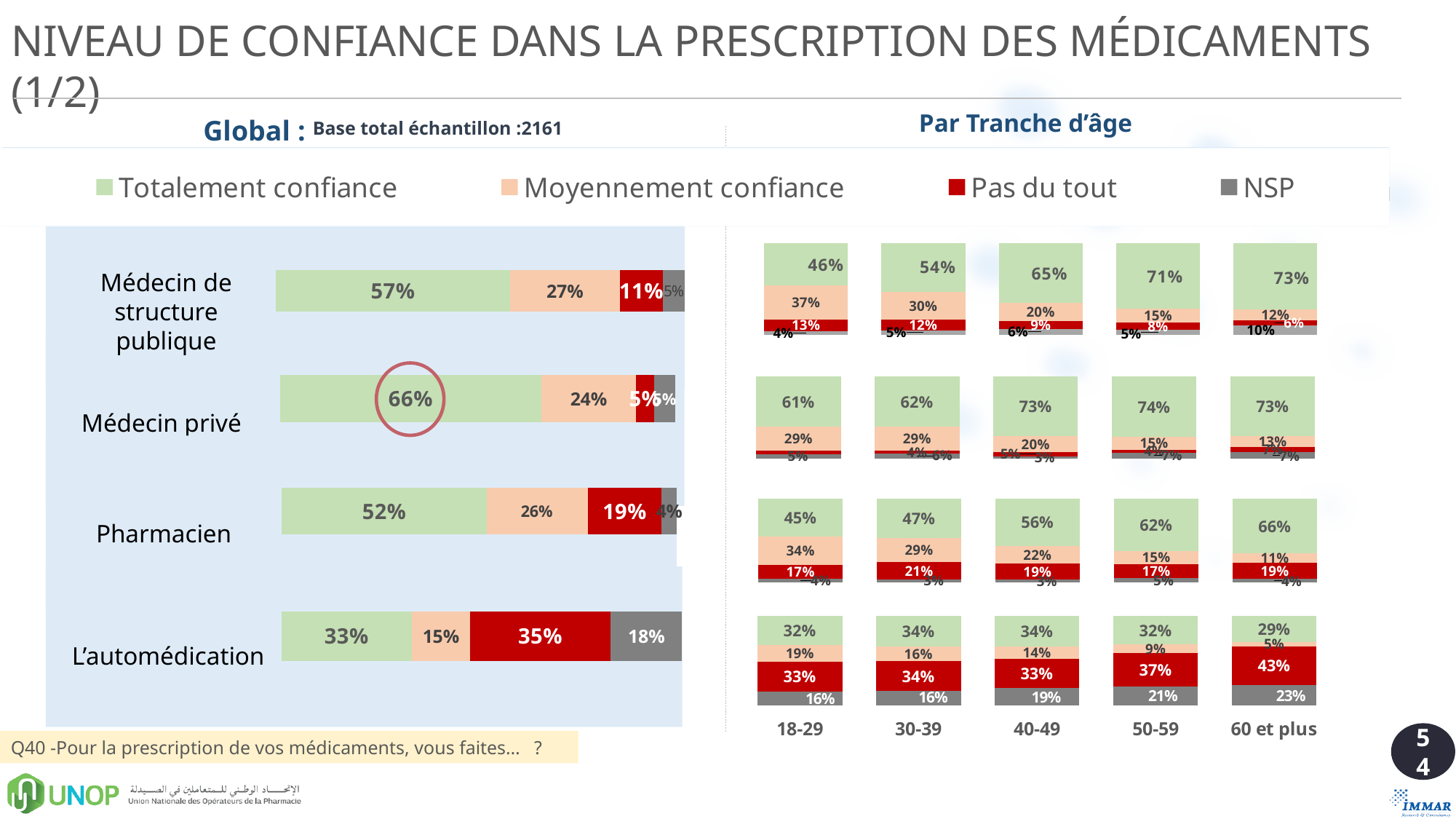
In the Global chart, what is the 'Totalement confiance' value for Médecin privé? 66% In the Global chart, which category has the lowest 'Totalement confiance' value? L'automédication What kind of chart is the Global chart? Stacked bar chart In the Global chart, what is the difference between the 'Totalement confiance' values for Médecin privé and Pharmacien? 14 percentage points In the 'Par Tranche d'âge' chart, what is the 'Pas du tout' value for L'automédication in the '60 et plus' age group? 43% In the Global chart, what is the 'Pas du tout' value for L'automédication? 35% In the Global chart, which has the larger 'Pas du tout' value: Pharmacien or Médecin de structure publique? Pharmacien In the 'Par Tranche d'âge' chart, does the 'Totalement confiance' value for Médecin de structure publique rise or fall from the 18-29 group to the 60 et plus group? Rises In the Global chart, which category has the highest 'Totalement confiance' value? Médecin privé How many series does the legend list? 4 How many categories are shown in the Global chart? 4 In the Global chart, which value is circled? 66%